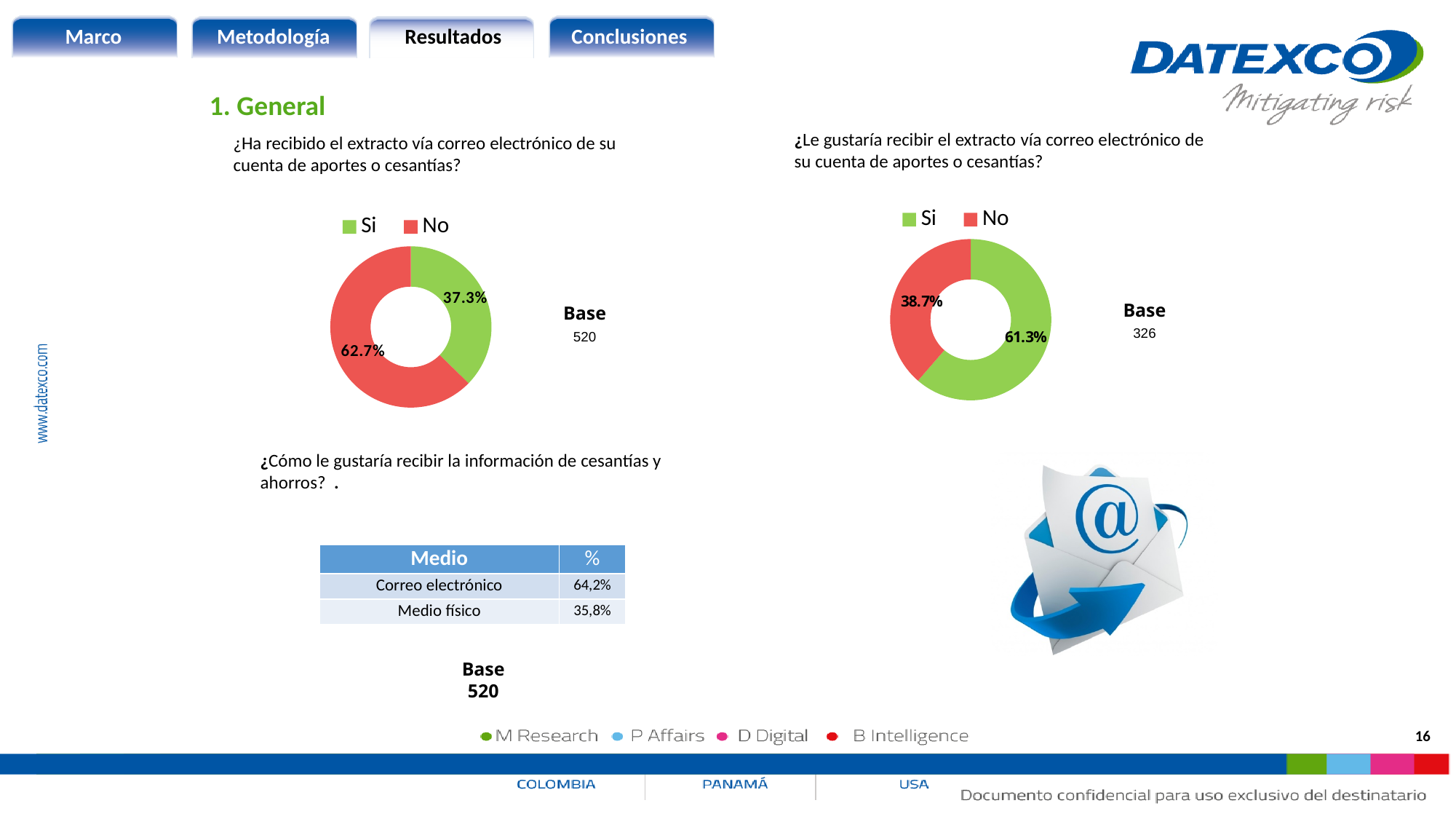
What is the Base shown next to the right chart (¿Le gustaría recibir el extracto...?)? 326 In the right chart (¿Le gustaría recibir el extracto vía correo electrónico...?), what percentage answered Si? 61.3% In the left chart (¿Ha recibido el extracto...?), what is the difference between the No and Si percentages? 25.4% In the right chart (¿Le gustaría recibir el extracto vía correo electrónico...?), what percentage answered No? 38.7% What type of chart is used for the question ¿Ha recibido el extracto vía correo electrónico...? Donut (pie) chart In the left chart (¿Ha recibido el extracto vía correo electrónico...?), what percentage answered No? 62.7% Is the Si share larger in the left chart (¿Ha recibido...?) or in the right chart (¿Le gustaría recibir...?)? Right chart In the right chart (¿Le gustaría recibir el extracto...?), what is the difference between the Si and No percentages? 22.6% In the right chart (¿Le gustaría recibir el extracto...?), which response has the smaller share? No How many categories does the legend of the right chart (¿Le gustaría recibir el extracto...?) list? 2 In the left chart (¿Ha recibido el extracto...?), which response has the larger share? No In the left chart (¿Ha recibido el extracto vía correo electrónico...?), what percentage answered Si? 37.3%